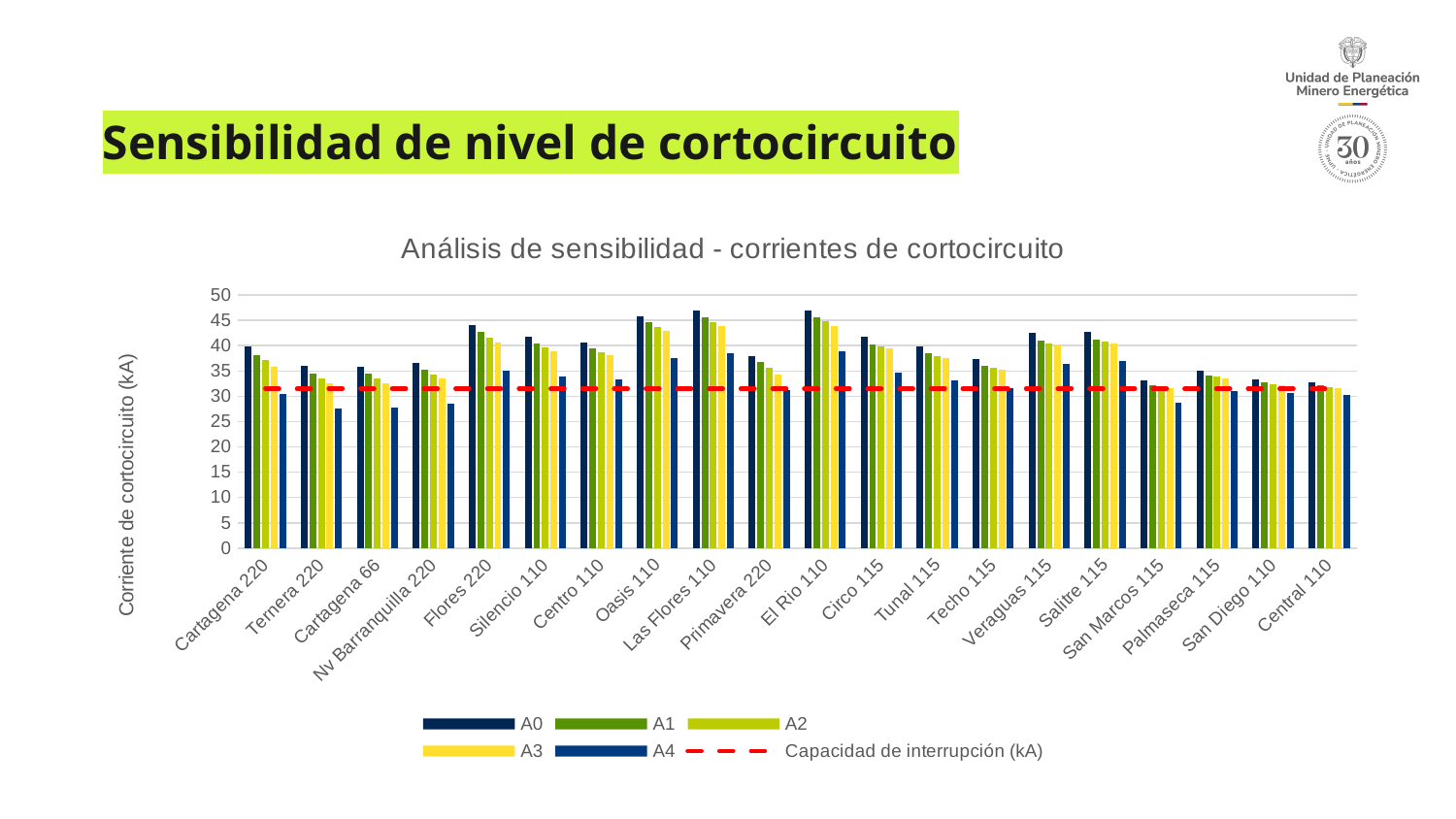
Which has a larger A4 value, Ternera 220 or Las Flores 110? Las Flores 110 Which has a larger A0 value, Las Flores 110 or Cartagena 220? Las Flores 110 Is the A4 value for Ternera 220 greater or less than 30? less Is the A0 value for Veraguas 115 greater or less than 40? greater Is the A0 value for Las Flores 110 greater or less than 45? greater How many categories are shown on the x axis of the chart? 20 How many series does the chart legend list? 6 What is the title of the chart? Análisis de sensibilidad - corrientes de cortocircuito What type of chart is shown on the slide? Bar chart What does the red dashed line in the chart represent, according to the legend? Capacidad de interrupción (kA)